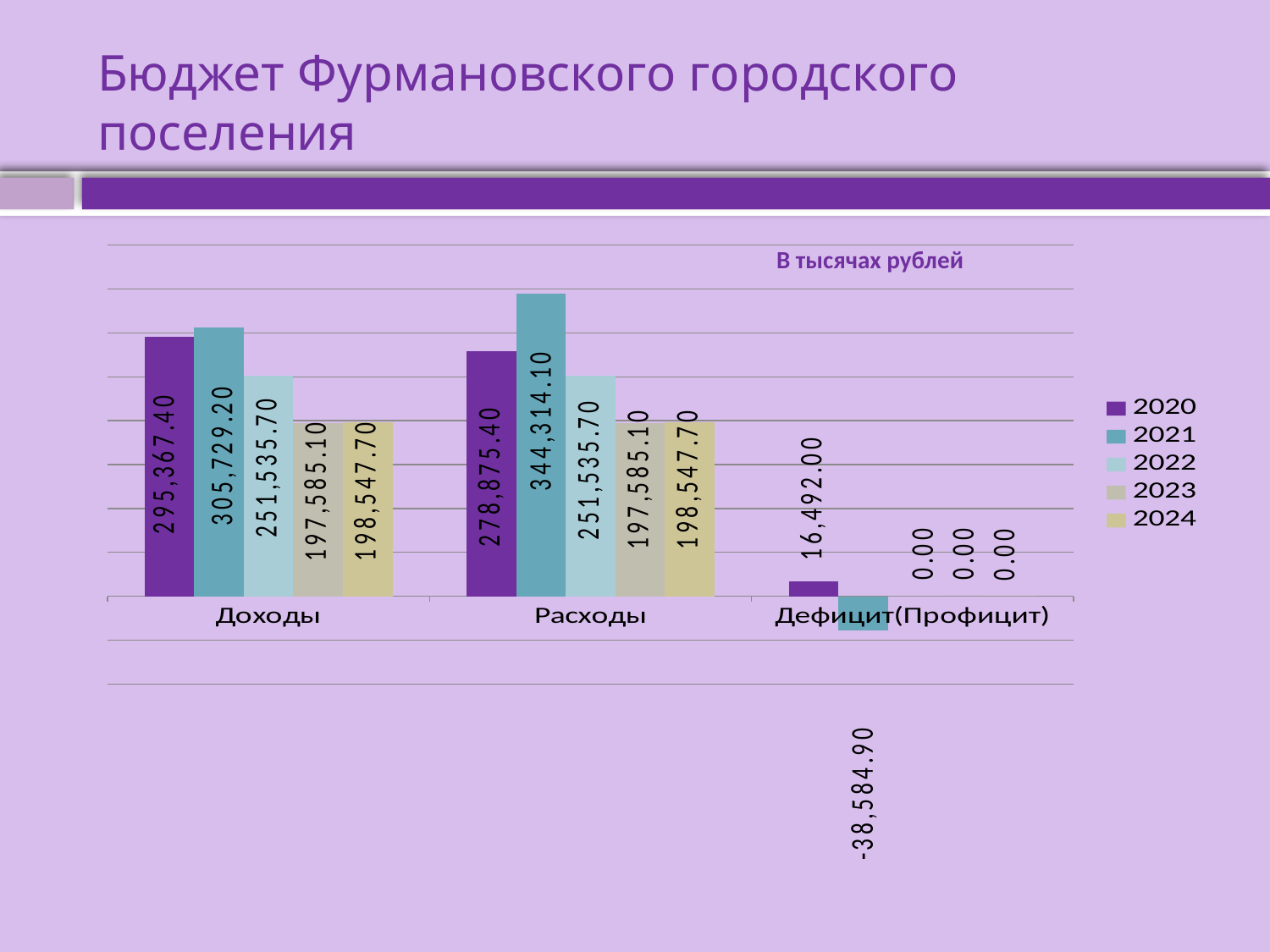
What is the value for Расходы in 2021? 344,314.10 How many series does the legend list? 5 Which year has the highest value for Расходы? 2021 What type of chart is shown on the slide? Bar chart Which year has the lowest value for Доходы? 2023 How many categories are shown on the x axis? 3 What unit is stated on the chart? В тысячах рублей What is the value for Доходы in 2021? 305,729.20 What is the value for Дефицит(Профицит) in 2020? 16,492.00 Which is larger in 2020: Доходы or Расходы? Доходы What is the value for Дефицит(Профицит) in 2021? -38,584.90 What is the difference between Расходы and Доходы in 2021? 38,584.90